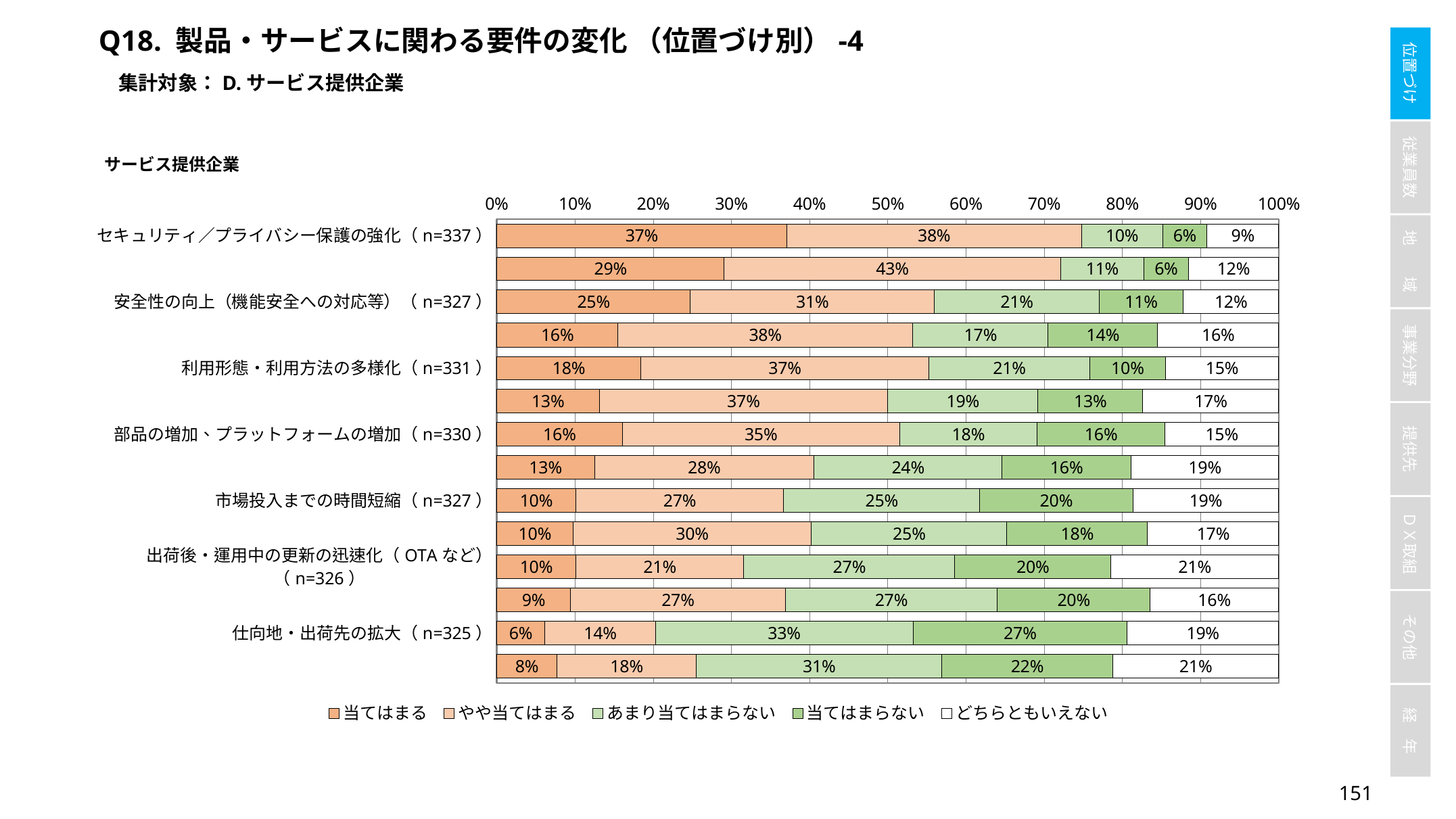
What is the value of どちらともいえない for 出荷後・運用中の更新の迅速化 (OTAなど) (n=326)? 21% What is the first entry in the chart legend? 当てはまる What is the difference between the 当てはまる value for セキュリティ／プライバシー保護の強化 and for 仕向地・出荷先の拡大? 31 percentage points What is the value of あまり当てはまらない for 仕向地・出荷先の拡大 (n=325)? 33% Which has the larger やや当てはまる value: 安全性の向上 (n=327) or 利用形態・利用方法の多様化 (n=331)? 利用形態・利用方法の多様化 Among the labeled categories, which has the highest 当てはまる value? セキュリティ／プライバシー保護の強化 What kind of chart is shown on the slide? Stacked bar chart What is the value of 当てはまる for セキュリティ／プライバシー保護の強化 (n=337)? 37% What is the value of 当てはまらない for 市場投入までの時間短縮 (n=327)? 20% What is the combined share of 当てはまる and やや当てはまる for セキュリティ／プライバシー保護の強化? 75% Among the labeled categories, which has the lowest 当てはまる value? 仕向地・出荷先の拡大 How many series does the legend list? 5